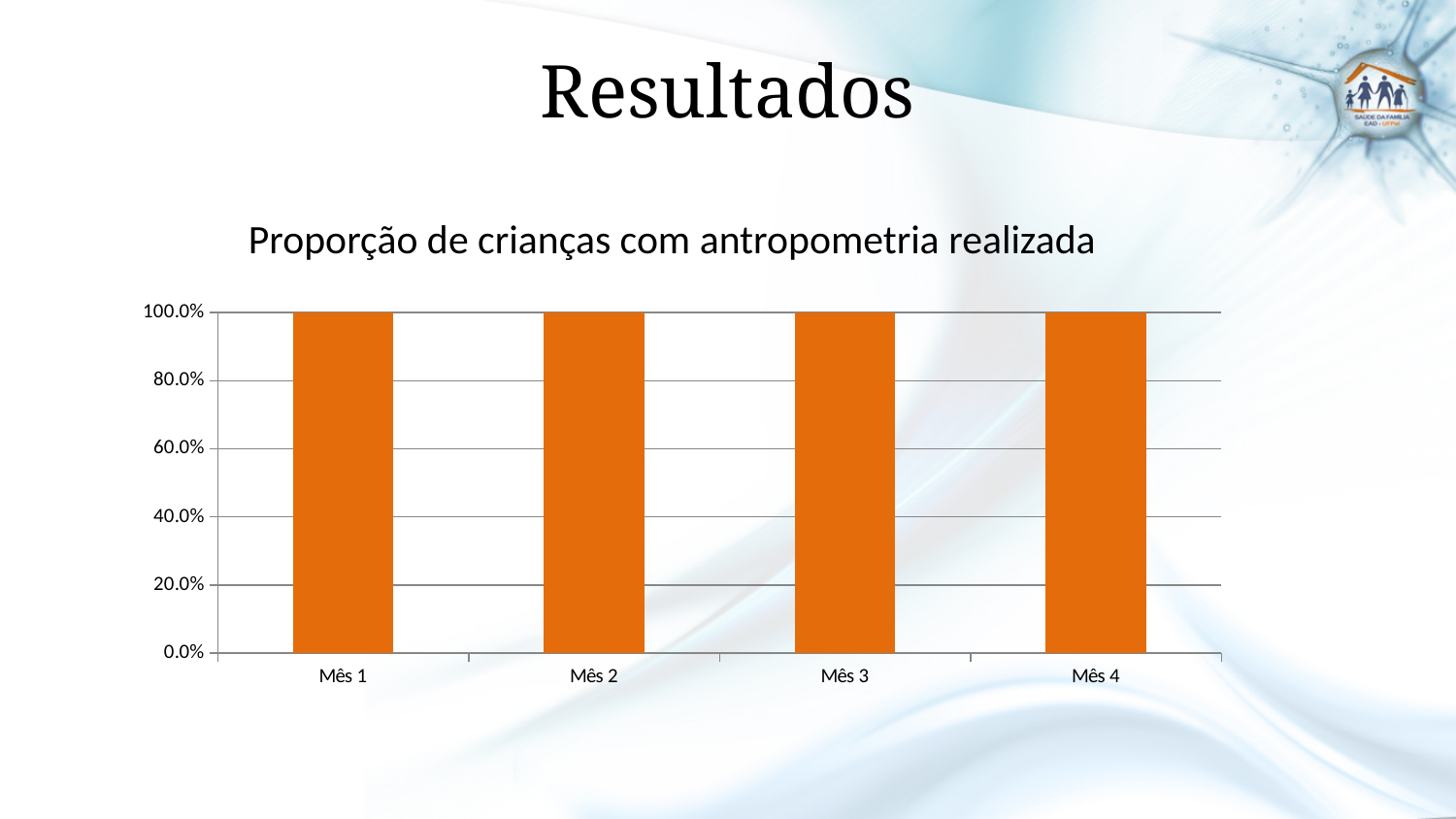
What is the value for Mês 1? 100.0% What type of chart is shown on the slide? bar chart What is the value for Mês 4? 100.0% Is the value for Mês 1 greater or less than 60.0%? greater What colour are the bars in the chart? orange What is the difference between the values for Mês 1 and Mês 4? 0.0% Is the value for Mês 3 greater or less than 80.0%? greater What is the value for Mês 3? 100.0% What is the title of the chart? Proporção de crianças com antropometria realizada How many categories are shown on the x axis of the chart? 4 Do the values rise, fall or stay the same from Mês 1 to Mês 4? stay the same What is the value for Mês 2? 100.0%